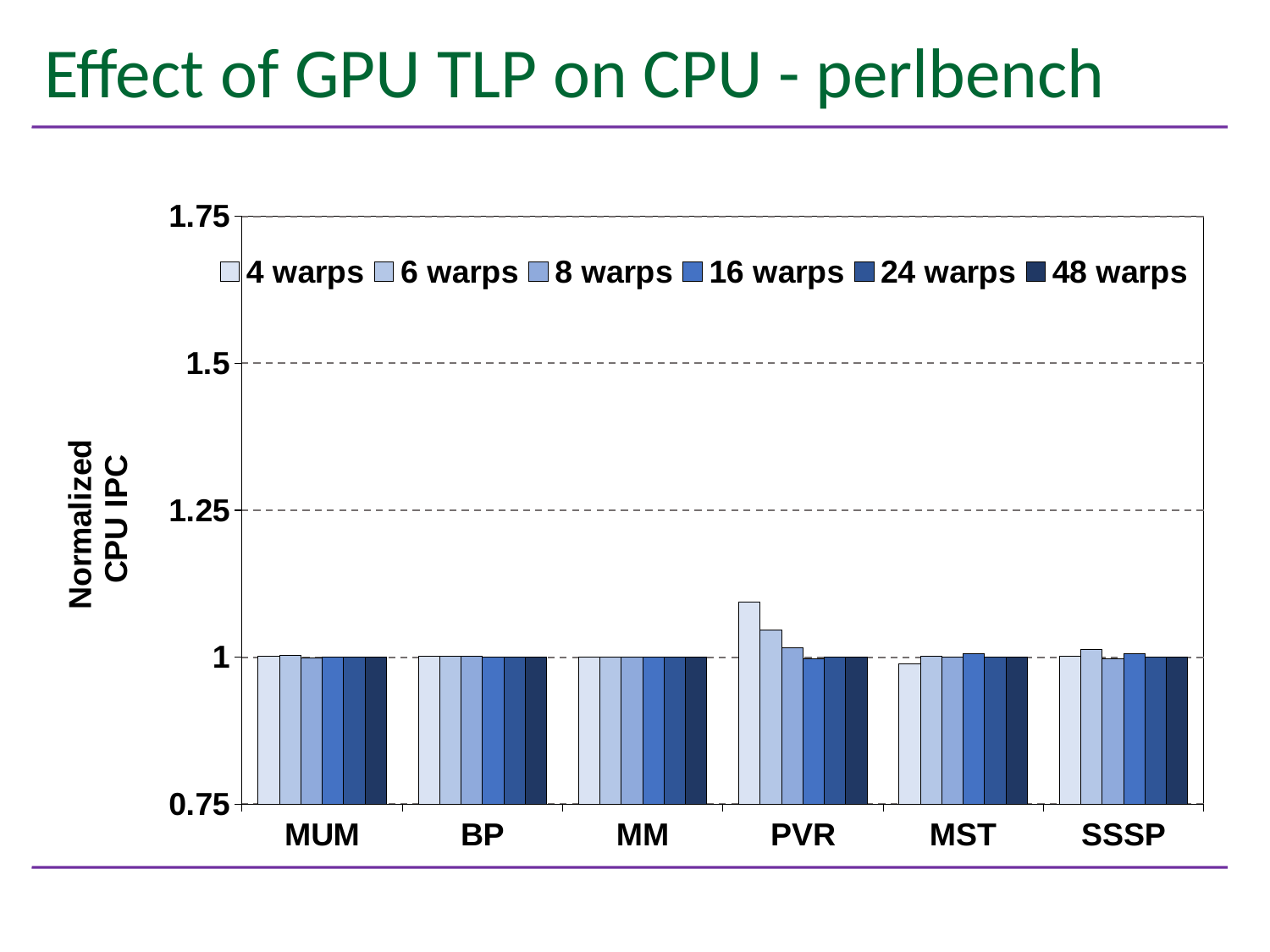
What kind of chart is shown on the slide? bar chart Which category has the tallest bar in the chart? PVR What is the label of the y axis? Normalized CPU IPC What is the title of the slide containing the chart? Effect of GPU TLP on CPU - perlbench Is the value for PVR with 4 warps greater or less than 1? greater How many benchmark categories are shown on the x axis? 6 For PVR, which is larger: the 4 warps bar or the 6 warps bar? 4 warps Is the value for MUM with 4 warps greater or less than 1.25? less Is the value for PVR with 4 warps greater or less than 1.25? less How many series does the legend list? 6 For PVR, do the bars rise or fall going from 4 warps to 16 warps? fall Which series in the legend is drawn in the lightest shade of blue? 4 warps